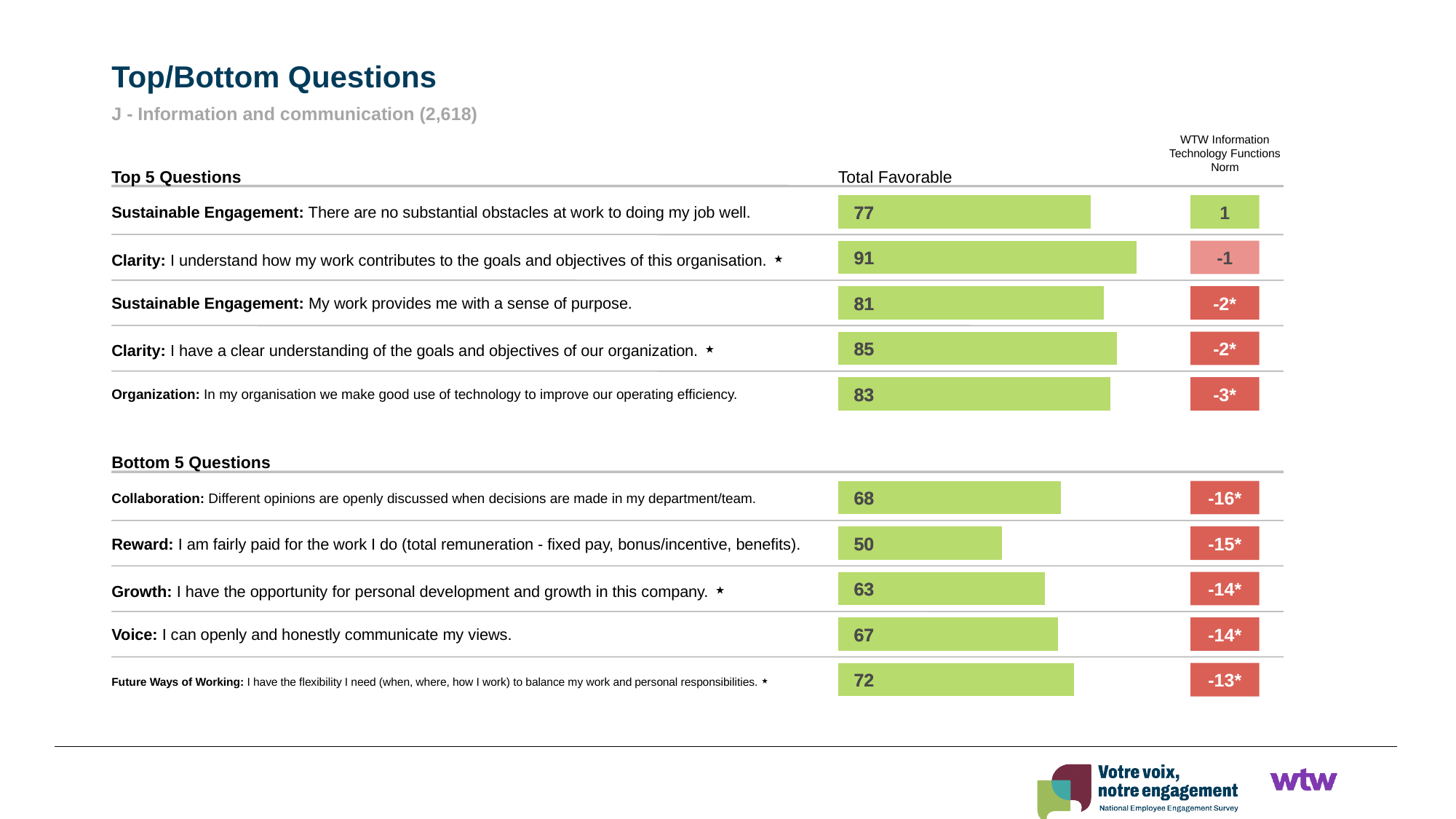
In the Bottom 5 Questions chart, what is the WTW Information Technology Functions Norm difference for "Collaboration: Different opinions are openly discussed when decisions are made in my department/team"? -16* What kind of chart is used to show the Total Favorable values on this slide? Bar chart What is the subtitle shown under the slide title "Top/Bottom Questions"? J - Information and communication (2,618) In the Bottom 5 Questions chart, which has a higher Total Favorable value: "Voice: I can openly and honestly communicate my views" or "Growth: I have the opportunity for personal development and growth in this company"? Voice: I can openly and honestly communicate my views. In the Top 5 Questions chart, what is the Total Favorable value for "Sustainable Engagement: My work provides me with a sense of purpose"? 81 In the Top 5 Questions chart, what is the difference in Total Favorable between "Clarity: I have a clear understanding of the goals and objectives of our organization" and "Sustainable Engagement: There are no substantial obstacles at work to doing my job well"? 8 In the Top 5 Questions chart, what is the Total Favorable value for "Clarity: I understand how my work contributes to the goals and objectives of this organisation"? 91 In the Top 5 Questions chart, what is the WTW Information Technology Functions Norm difference for "Organization: In my organisation we make good use of technology to improve our operating efficiency"? -3* How many questions are shown in the Bottom 5 Questions chart? 5 In the Bottom 5 Questions chart, what is the Total Favorable value for "Reward: I am fairly paid for the work I do"? 50 In the Top 5 Questions chart, which question has the highest Total Favorable value? Clarity: I understand how my work contributes to the goals and objectives of this organisation. In the Bottom 5 Questions chart, which question has the lowest Total Favorable value? Reward: I am fairly paid for the work I do (total remuneration - fixed pay, bonus/incentive, benefits).